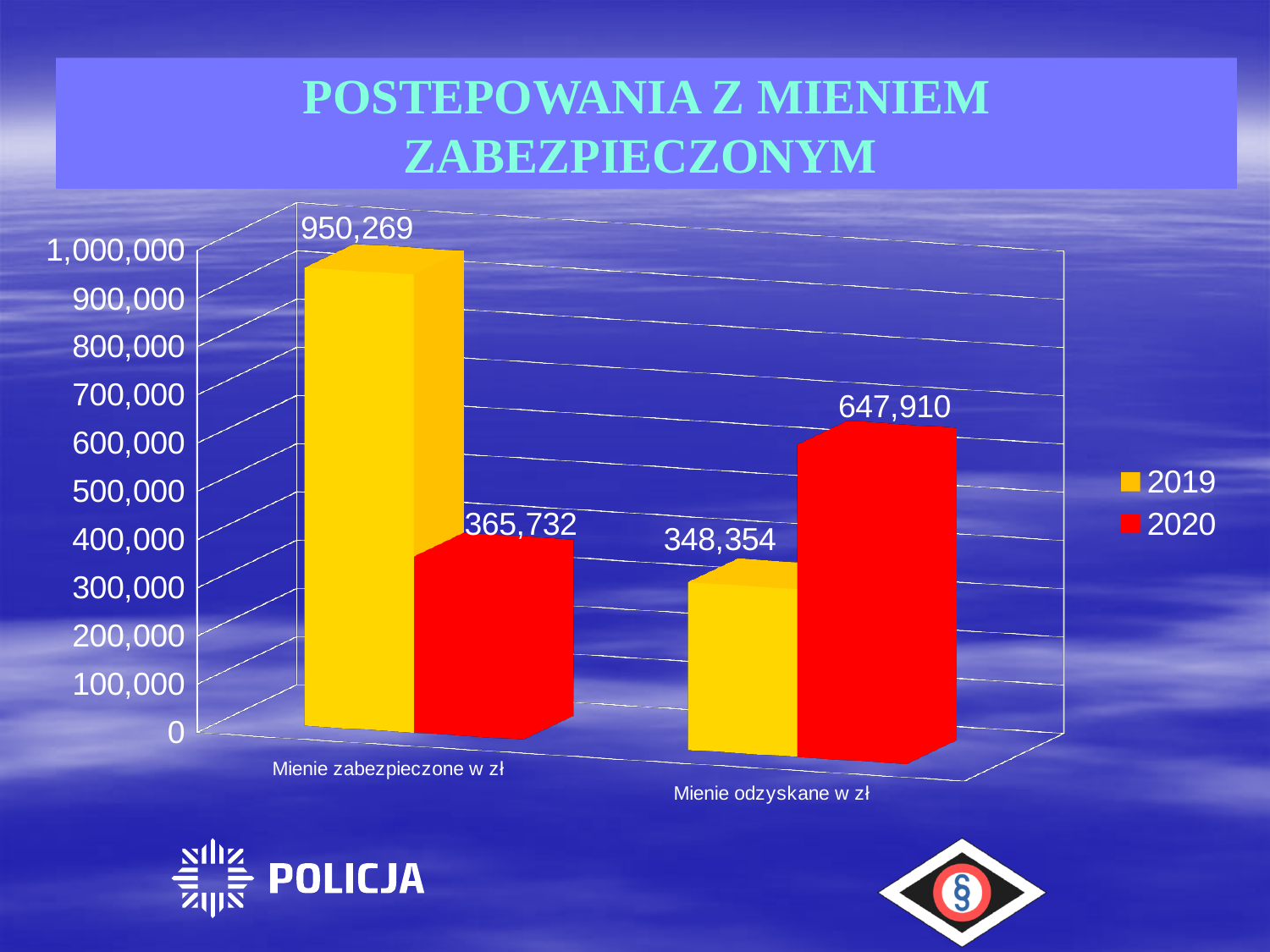
How many categories are shown on the x axis? 2 What is the value for 2020 in the 'Mienie zabezpieczone w zł' category? 365,732 What is the value for 2019 in the 'Mienie odzyskane w zł' category? 348,354 What is the value for 2020 in the 'Mienie odzyskane w zł' category? 647,910 Which is larger for 'Mienie odzyskane w zł': the 2019 value or the 2020 value? 2020 What kind of chart is shown on the slide? Bar chart What is the difference between the 2019 and 2020 values for 'Mienie zabezpieczone w zł'? 584,537 Which category has the lowest value for the 2020 series? Mienie zabezpieczone w zł Which category has the highest value for the 2019 series? Mienie zabezpieczone w zł What is the value for 2019 in the 'Mienie zabezpieczone w zł' category? 950,269 What is the difference between the 2020 and 2019 values for 'Mienie odzyskane w zł'? 299,556 How many series does the legend list? 2